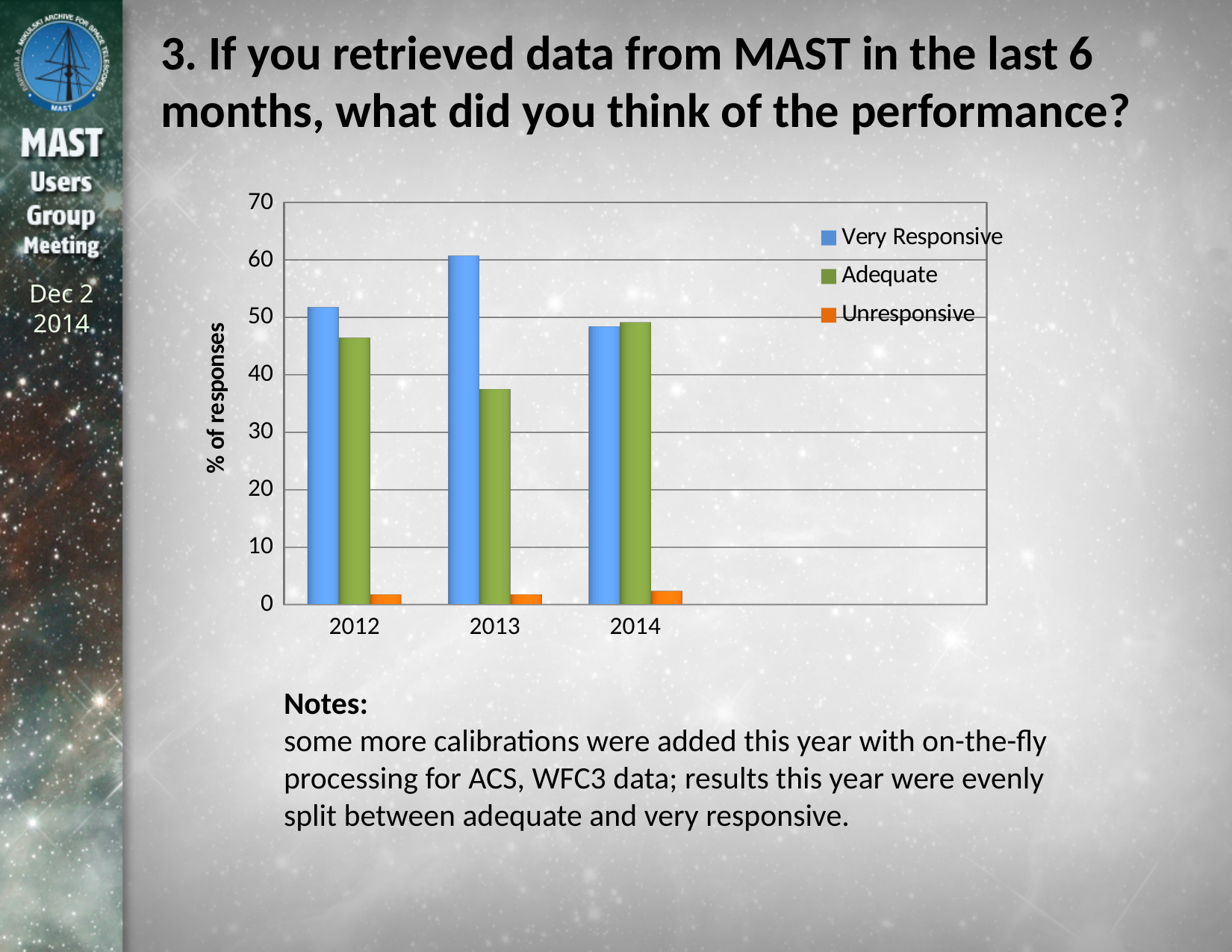
Is the Unresponsive value for 2014 greater or less than 10? less Which series has the lowest values in every year? Unresponsive Is the Adequate value for 2013 greater or less than 40? less In 2013, which is larger: Very Responsive or Adequate? Very Responsive How many years are shown on the x axis? 3 In which year is the Adequate bar lowest? 2013 In 2012, which is larger: Very Responsive or Adequate? Very Responsive In which year is the Very Responsive bar highest? 2013 What is the label on the y axis? % of responses How many series does the legend list? 3 What kind of chart is shown on the slide? bar chart